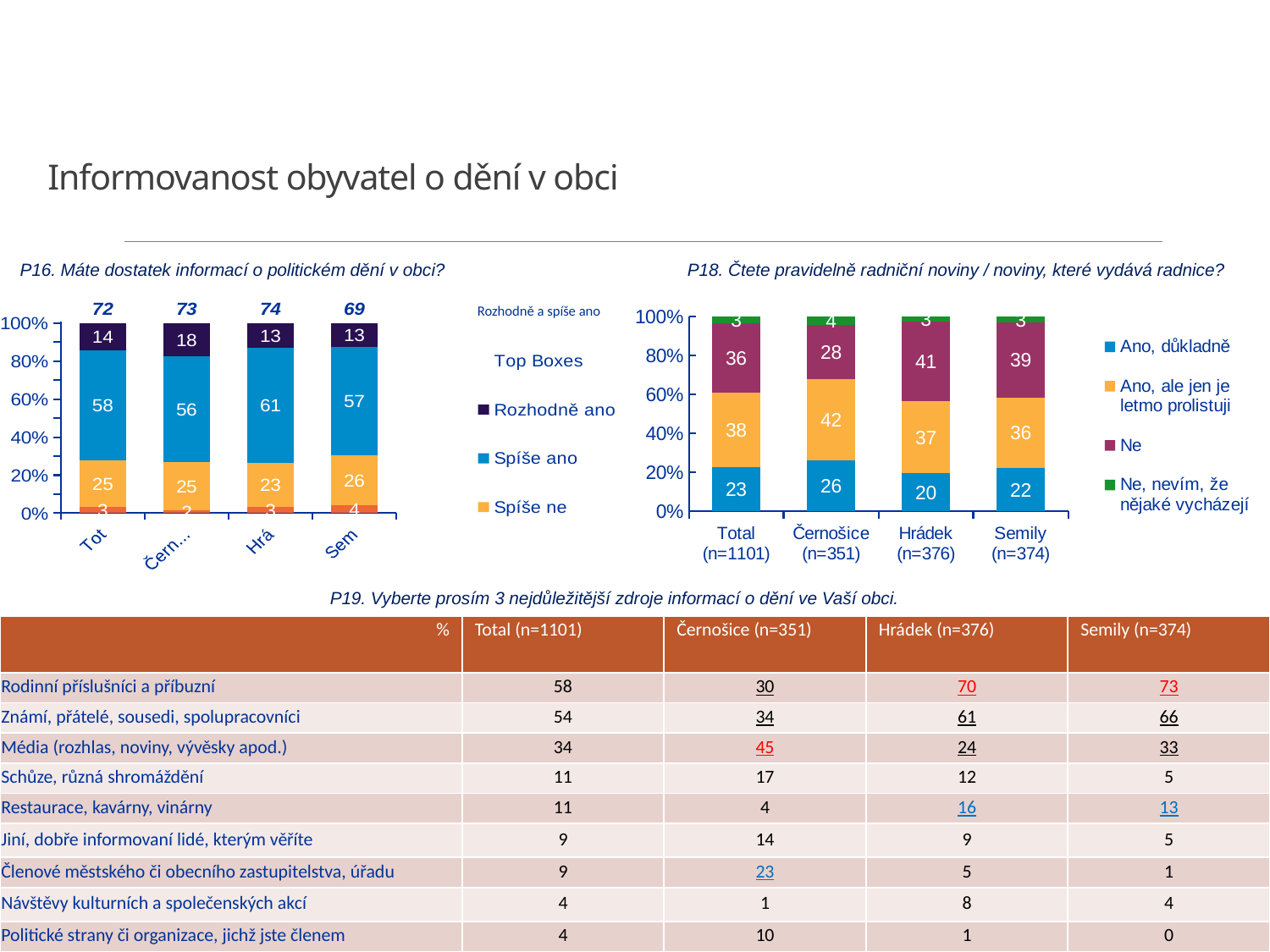
What kind of chart is the P18 chart (right)? Stacked bar chart In the P16 chart (left), which bar has the highest value for 'Spíše ano'? The third bar (Hrá) In the P16 chart (left), what is the value for 'Spíše ano' for the first bar (Tot)? 58 In the P18 chart (right), for Semily (n=374), which is larger: 'Ne' or 'Ano, ale jen je letmo prolistuji'? Ne How many categories are shown on the x axis of the P18 chart (right)? 4 How many series does the legend of the P18 chart (right) list? 4 In the P18 chart (right), which category has the highest value for 'Ano, ale jen je letmo prolistuji'? Černošice (n=351) In the P16 chart (left), what Top Boxes value is printed above the first bar (Tot)? 72 In the P18 chart (right), which category has the lowest value for 'Ano, důkladně'? Hrádek (n=376) In the P18 chart (right), what is the value for 'Ano, důkladně' for Černošice (n=351)? 26 In the P18 chart (right), what is the difference between the 'Ne' values for Hrádek (n=376) and Černošice (n=351)? 13 In the P18 chart (right), what is the value for 'Ne' for Hrádek (n=376)? 41